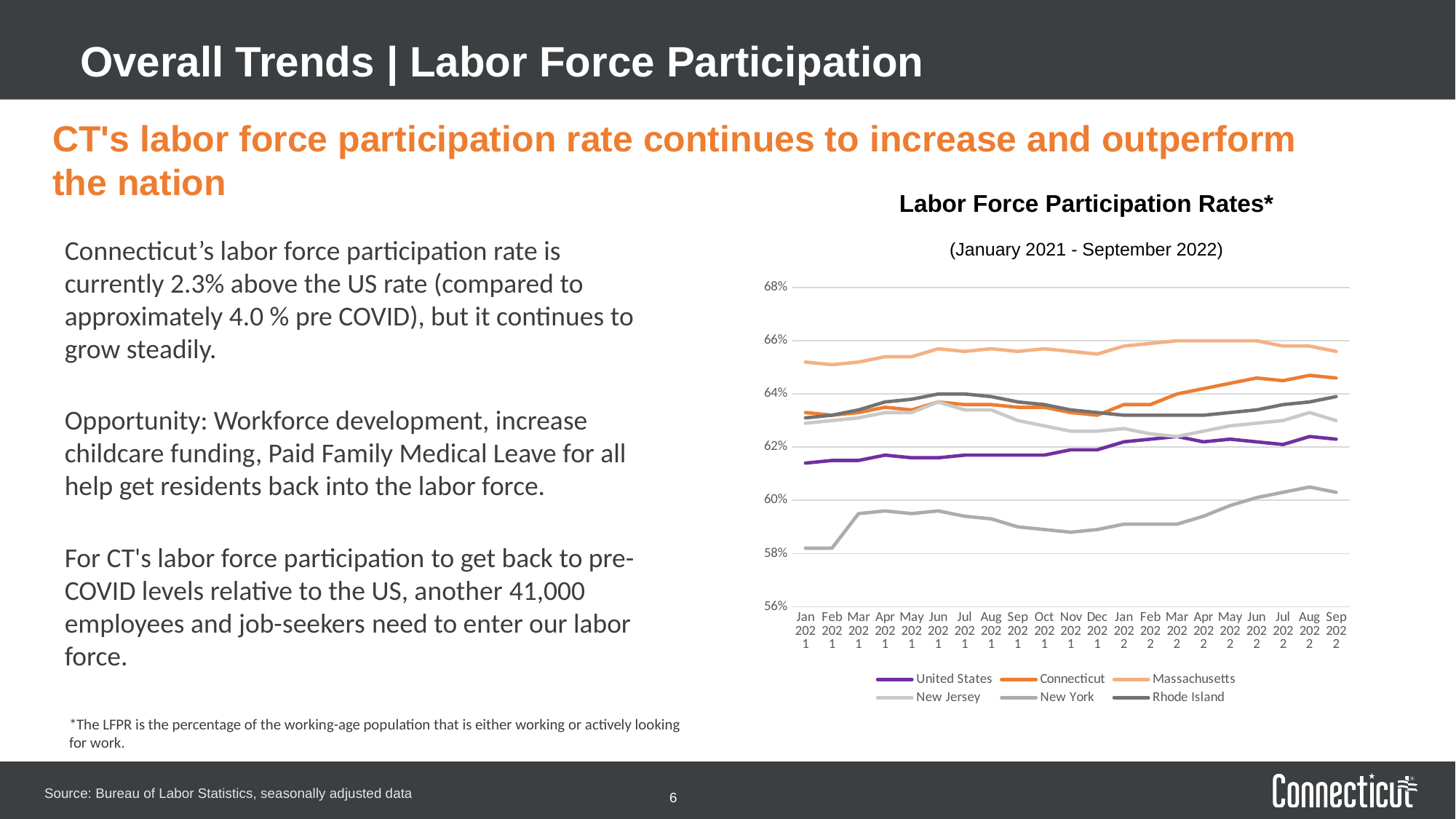
Is the value for New York in Jan 2021 greater or less than 60%? less In Sep 2022, which is higher: the Connecticut rate or the United States rate? Connecticut Does the Connecticut line rise or fall from Jan 2021 to Sep 2022? Rises How many monthly data points are plotted along the x axis of the chart? 21 Which series has the lowest labor force participation rate in Sep 2022? New York Which series has the highest labor force participation rate in Sep 2022? Massachusetts Is the value for the United States in Jan 2021 greater or less than 62%? less Is the value for Connecticut in Sep 2022 greater or less than 64%? greater What kind of chart is shown on the slide? Line chart How many series does the legend of the Labor Force Participation Rates chart list? 6 What period does the chart subtitle say the data covers? January 2021 - September 2022